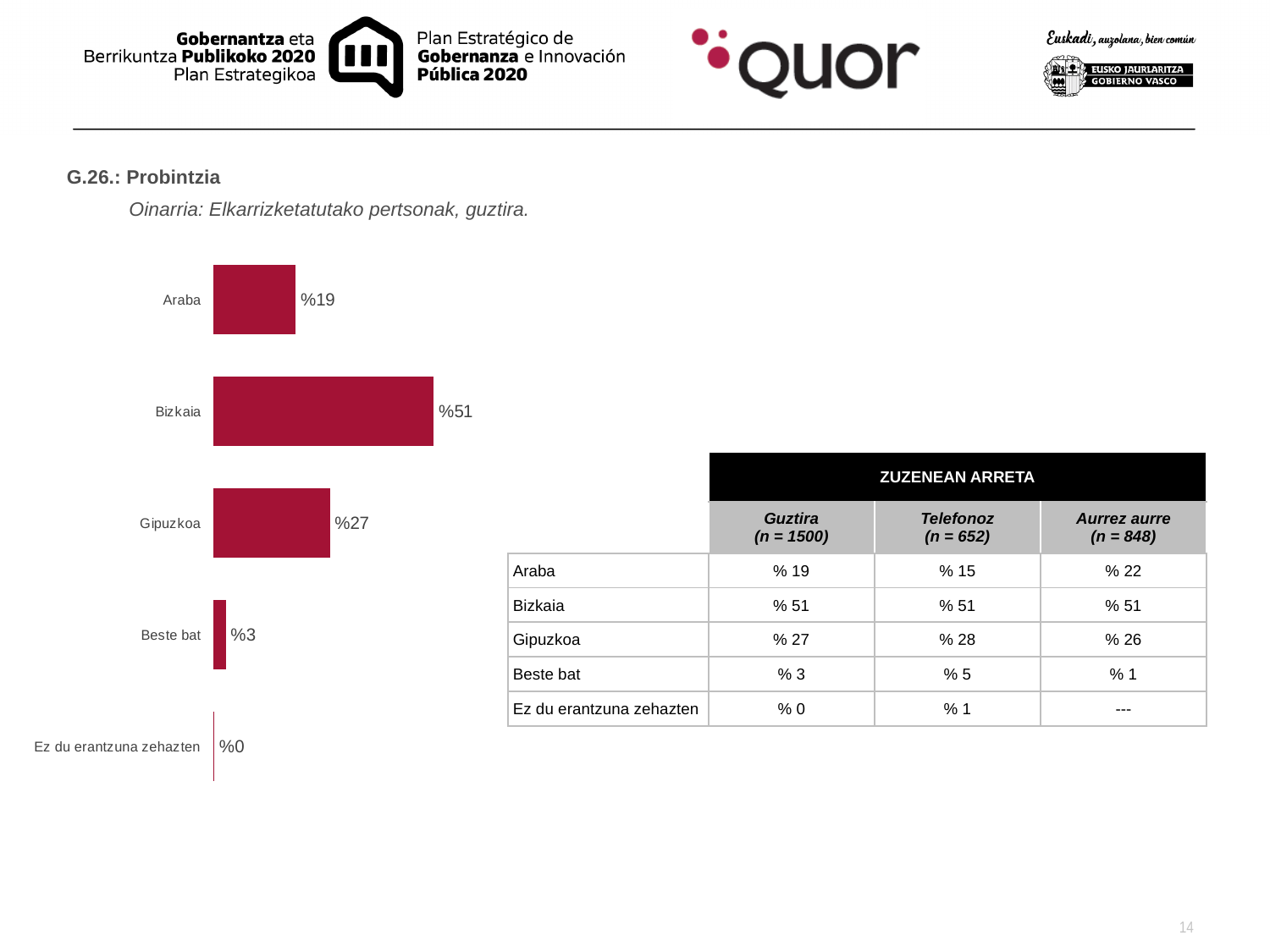
What is the value for Gipuzkoa in the bar chart? %27 Which has a larger value in the bar chart, Araba or Gipuzkoa? Gipuzkoa What is the difference between the values for Bizkaia and Gipuzkoa in the bar chart? 24 What kind of chart is shown on the slide? Bar chart What is the value for Beste bat in the bar chart? %3 How many categories are shown in the bar chart? 5 What is the value for Bizkaia in the bar chart? %51 What is the difference between the values for Gipuzkoa and Araba in the bar chart? 8 What is the value for Araba in the bar chart? %19 Which category has the highest value in the bar chart? Bizkaia Which category has the lowest value in the bar chart? Ez du erantzuna zehazten What is the value for Ez du erantzuna zehazten in the bar chart? %0